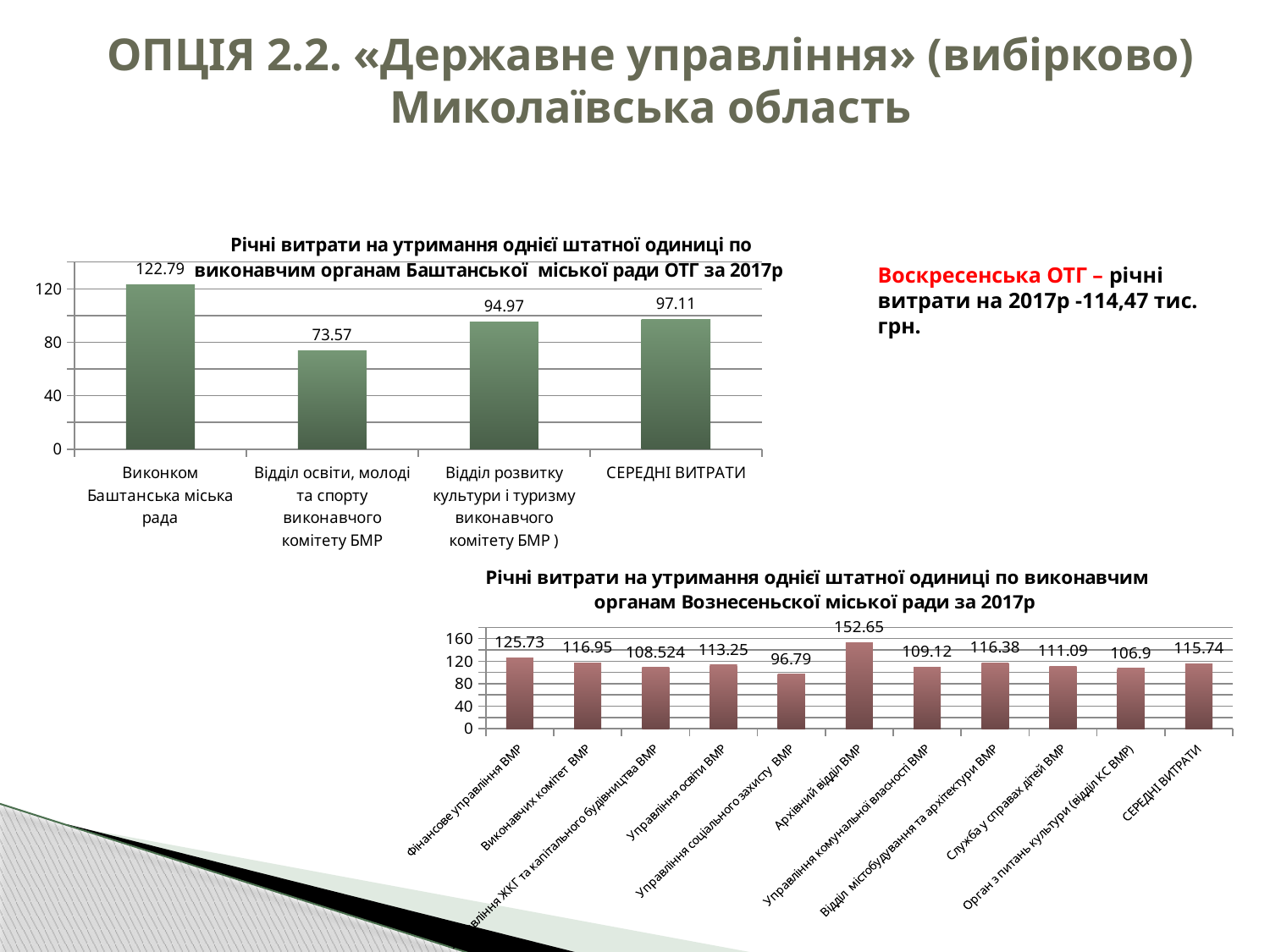
In the bottom chart (Вознесенська міська рада), what is the value for Архівний відділ ВМР? 152.65 In the bottom chart (Вознесенська міська рада), which category has the highest value? Архівний відділ ВМР In the bottom chart (Вознесенська міська рада), which category has the lowest value? Управління соціального захисту ВМР In the top chart (Баштанська міська рада), which category has the lowest value? Відділ освіти, молоді та спорту виконавчого комітету БМР In the top chart (Баштанська міська рада), what is the value for Відділ освіти, молоді та спорту виконавчого комітету БМР? 73.57 In the top chart (Баштанська міська рада), how many categories are shown? 4 In the top chart (Баштанська міська рада), what is the value for Виконком Баштанська міська рада? 122.79 In the bottom chart (Вознесенська міська рада), what is the value for СЕРЕДНІ ВИТРАТИ? 115.74 In the bottom chart (Вознесенська міська рада), which is larger: Фінансове управління ВМР or Виконавчих комітет ВМР? Фінансове управління ВМР In the bottom chart (Вознесенська міська рада), how many categories are shown? 11 What type of chart is the bottom chart (Вознесенська міська рада)? Bar chart In the top chart (Баштанська міська рада), what is the difference between Виконком Баштанська міська рада and СЕРЕДНІ ВИТРАТИ? 25.68